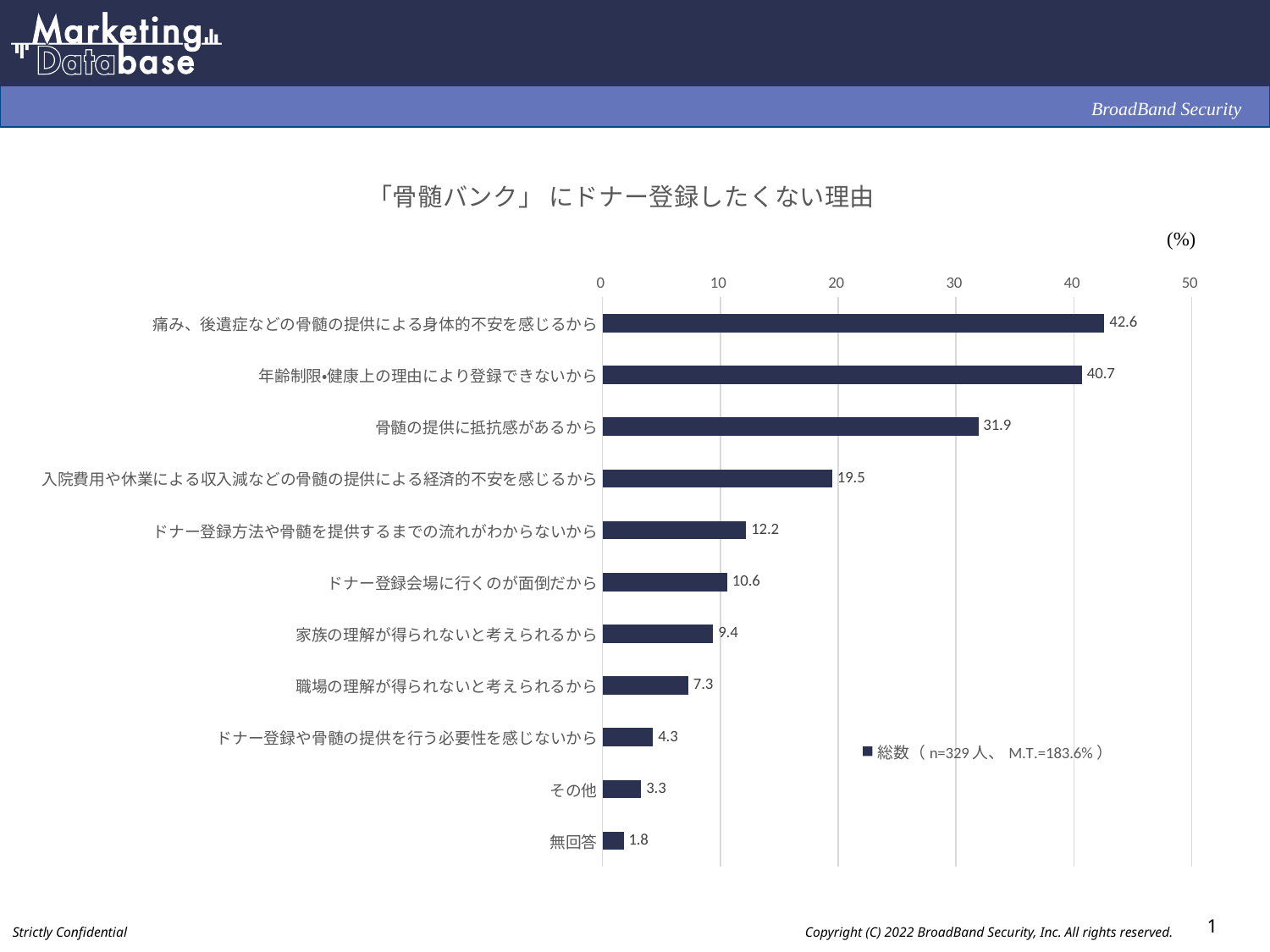
What is the title of the chart? 「骨髄バンク」 にドナー登録したくない理由 Which category has the highest value? 痛み、後遺症などの骨髄の提供による身体的不安を感じるから How many categories are shown in the chart? 11 What kind of chart is shown on the slide? bar chart What is the value for 骨髄の提供に抵抗感があるから? 31.9 What is the difference between the values for 年齢制限•健康上の理由により登録できないから and 骨髄の提供に抵抗感があるから? 8.8 Which category has the lowest value? 無回答 Is the value for 入院費用や休業による収入減などの骨髄の提供による経済的不安を感じるから greater or less than 20? less What is the value for ドナー登録会場に行くのが面倒だから? 10.6 How many series does the legend list? 1 What is the value for 痛み、後遺症などの骨髄の提供による身体的不安を感じるから? 42.6 Which is larger: the value for 家族の理解が得られないと考えられるから or 職場の理解が得られないと考えられるから? 家族の理解が得られないと考えられるから